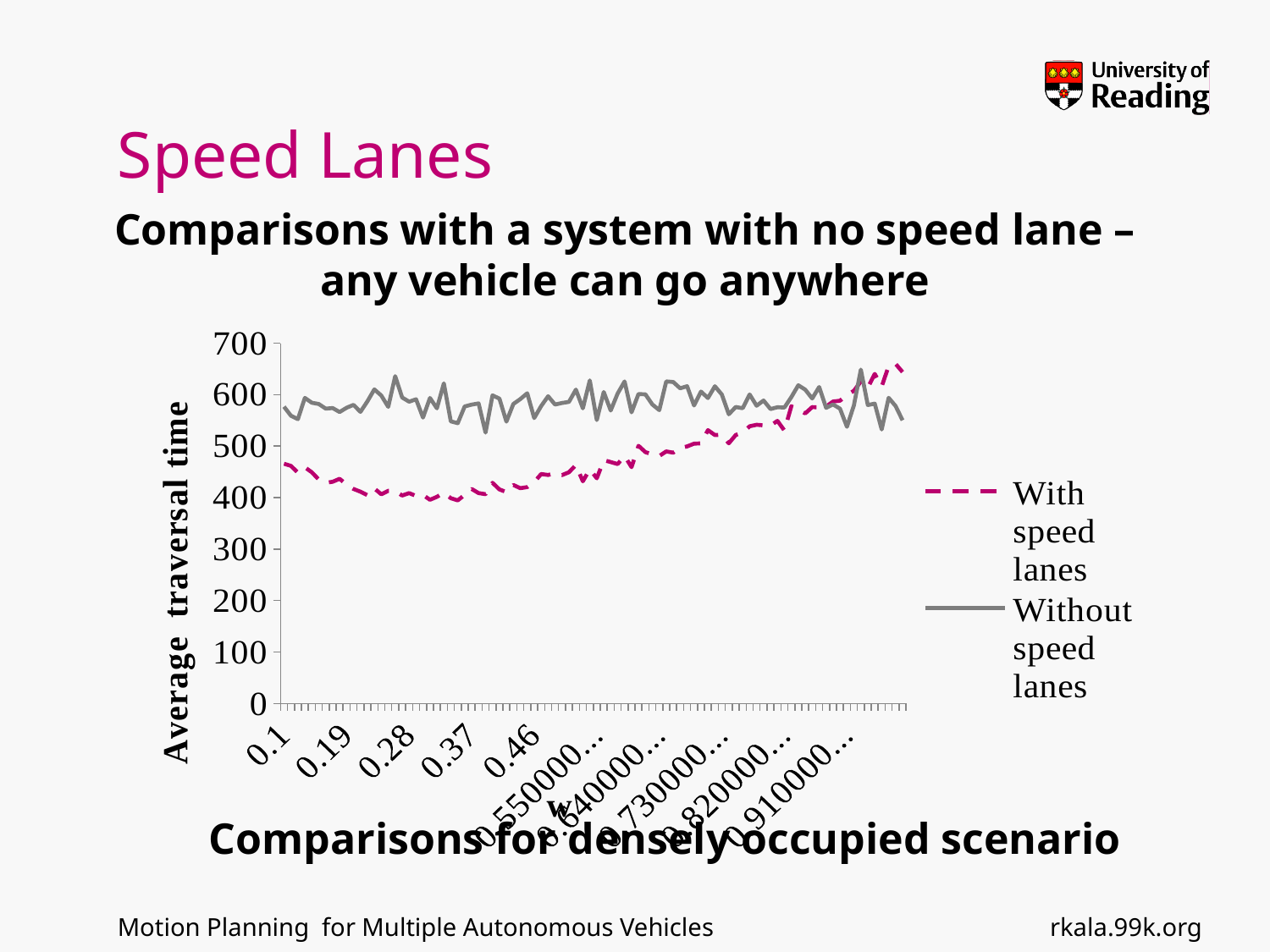
Is the value for 'With speed lanes' at 0.1 greater or less than 400? greater Is the value for 'With speed lanes' at 0.1 greater or less than 500? less Is the value for 'Without speed lanes' at 0.1 greater or less than 700? less What kind of chart is shown on the slide? line chart Does the 'With speed lanes' series overall rise or fall from the left end of the x axis to the right end? rise At 0.28, which series has the higher average traversal time, 'With speed lanes' or 'Without speed lanes'? Without speed lanes How many series does the legend list? 2 What is the highest tick value shown on the vertical axis? 700 At 0.1, which series has the higher average traversal time, 'With speed lanes' or 'Without speed lanes'? Without speed lanes What are the two series named in the legend? With speed lanes; Without speed lanes What is the title of the vertical axis? Average traversal time